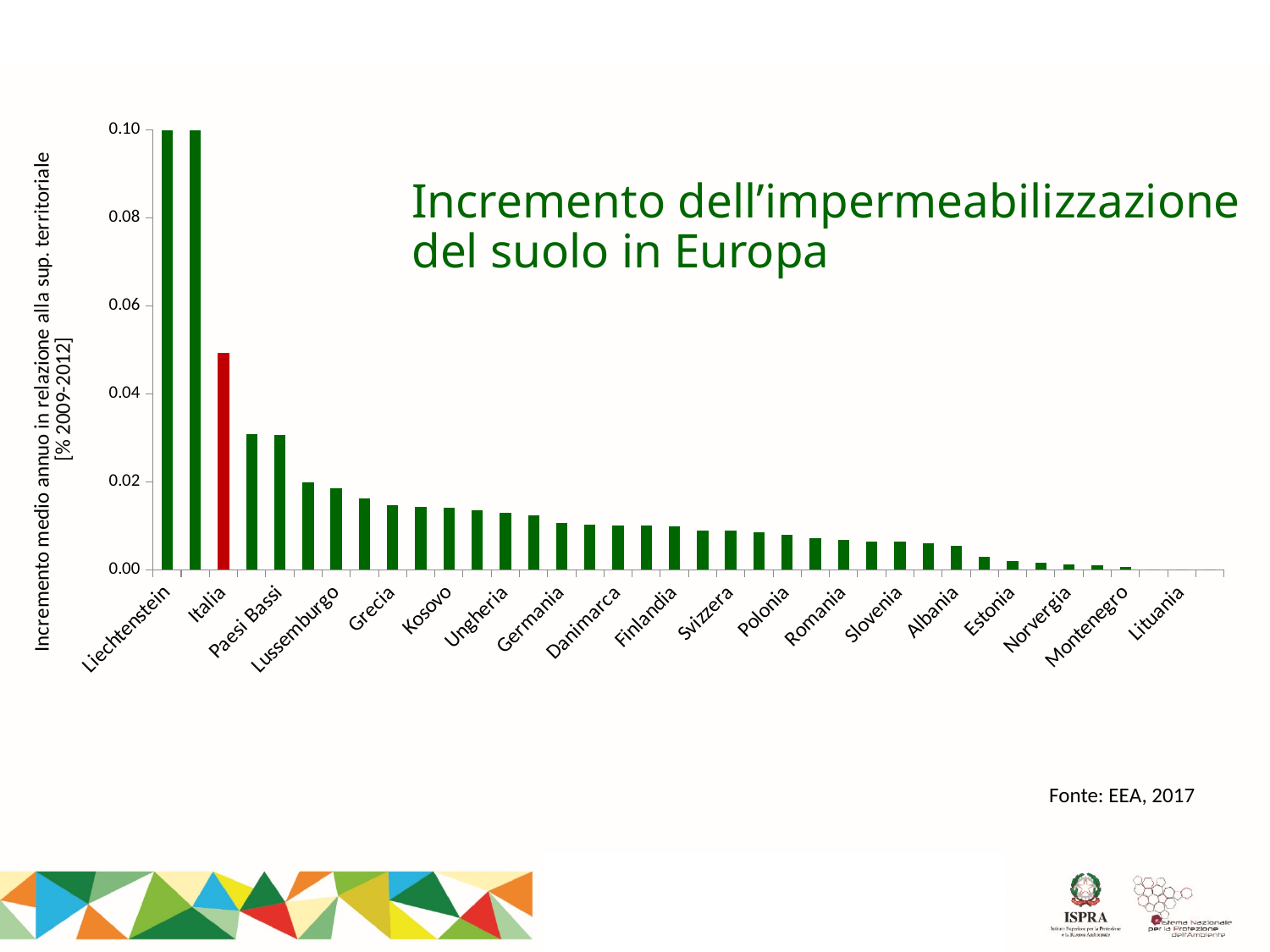
What kind of chart is shown on the slide? bar chart Which has the larger value, Liechtenstein or Italia? Liechtenstein Which has the larger value, Italia or Paesi Bassi? Italia Is the value for Italia greater or less than 0.06? less What is the title of the chart? Incremento dell'impermeabilizzazione del suolo in Europa Is the value for Italia greater or less than 0.04? greater Is the value for Paesi Bassi greater or less than 0.02? greater Do the values rise or fall moving from left to right along the x axis? fall Which country's bar is coloured red? Italia